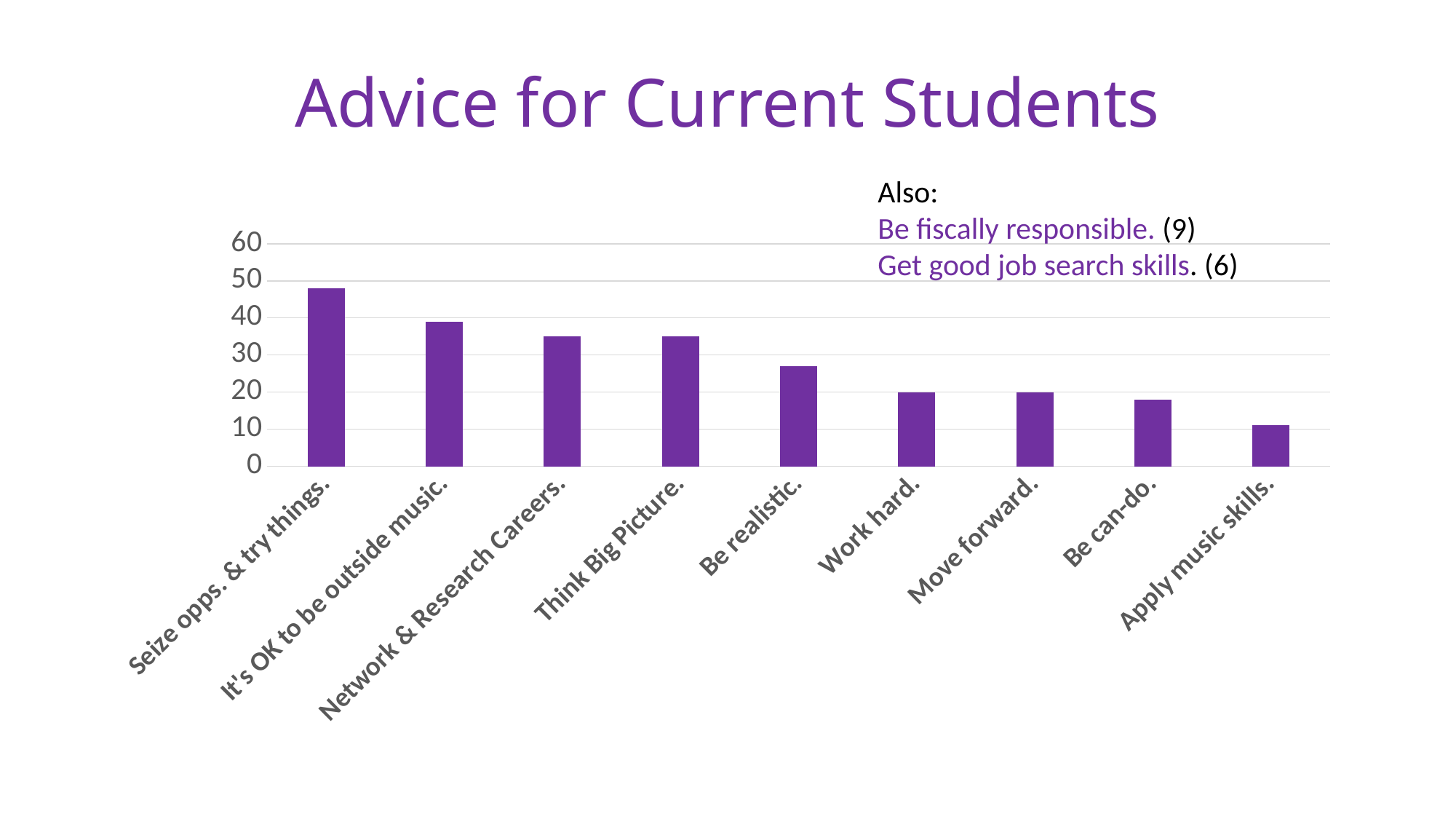
Which category has the lowest value? Apply music skills. Which category has the highest value? Seize opps. & try things. Is the value for 'Seize opps. & try things.' greater or less than 40? greater How many categories are plotted in the chart? 9 What kind of chart is shown on the slide? bar chart Which is larger, the value for 'Seize opps. & try things.' or the value for 'Be realistic.'? Seize opps. & try things. What colour are the bars in the chart? purple Is the value for 'Apply music skills.' greater or less than 20? less Is the value for 'Be realistic.' greater or less than 30? less What is the title of the slide? Advice for Current Students Do the values rise or fall moving from left to right along the x axis? fall